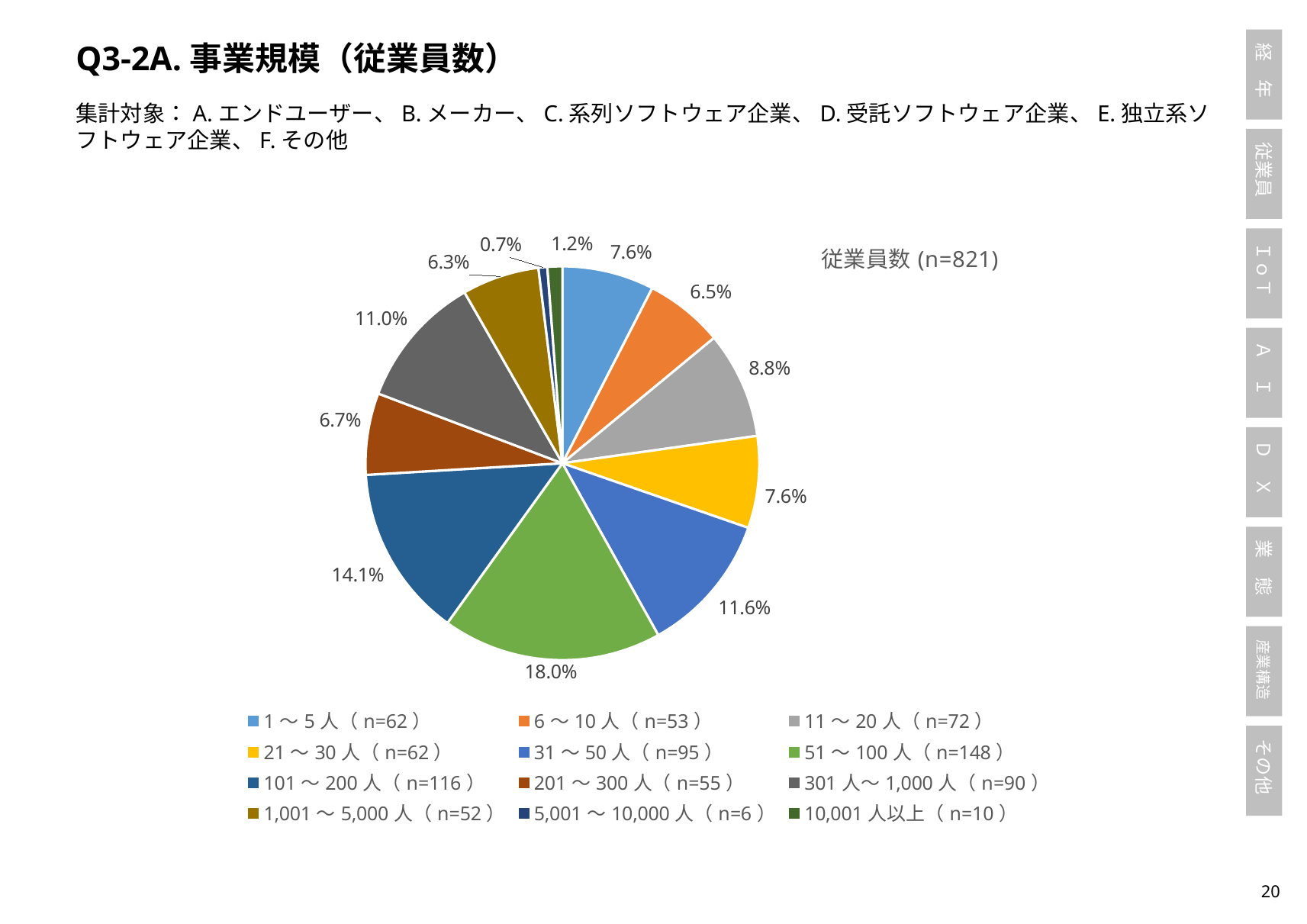
What is the n value shown in the legend for the 51～100人 category? n=148 How many categories does the pie chart have? 12 What is the difference between the shares of the 51～100人 and 101～200人 categories? 3.9% What share of the pie does the 5,001～10,000人 category have? 0.7% What kind of chart is shown on the slide? pie chart What is the title of the pie chart? 従業員数 (n=821) What share of the pie does the 101～200人 category have? 14.1% Which category has the smallest share of the pie? 5,001～10,000人 Which category has the largest share of the pie? 51～100人 What share of the pie does the 51～100人 category have? 18.0% Which has a larger share, 31～50人 or 301人～1,000人? 31～50人